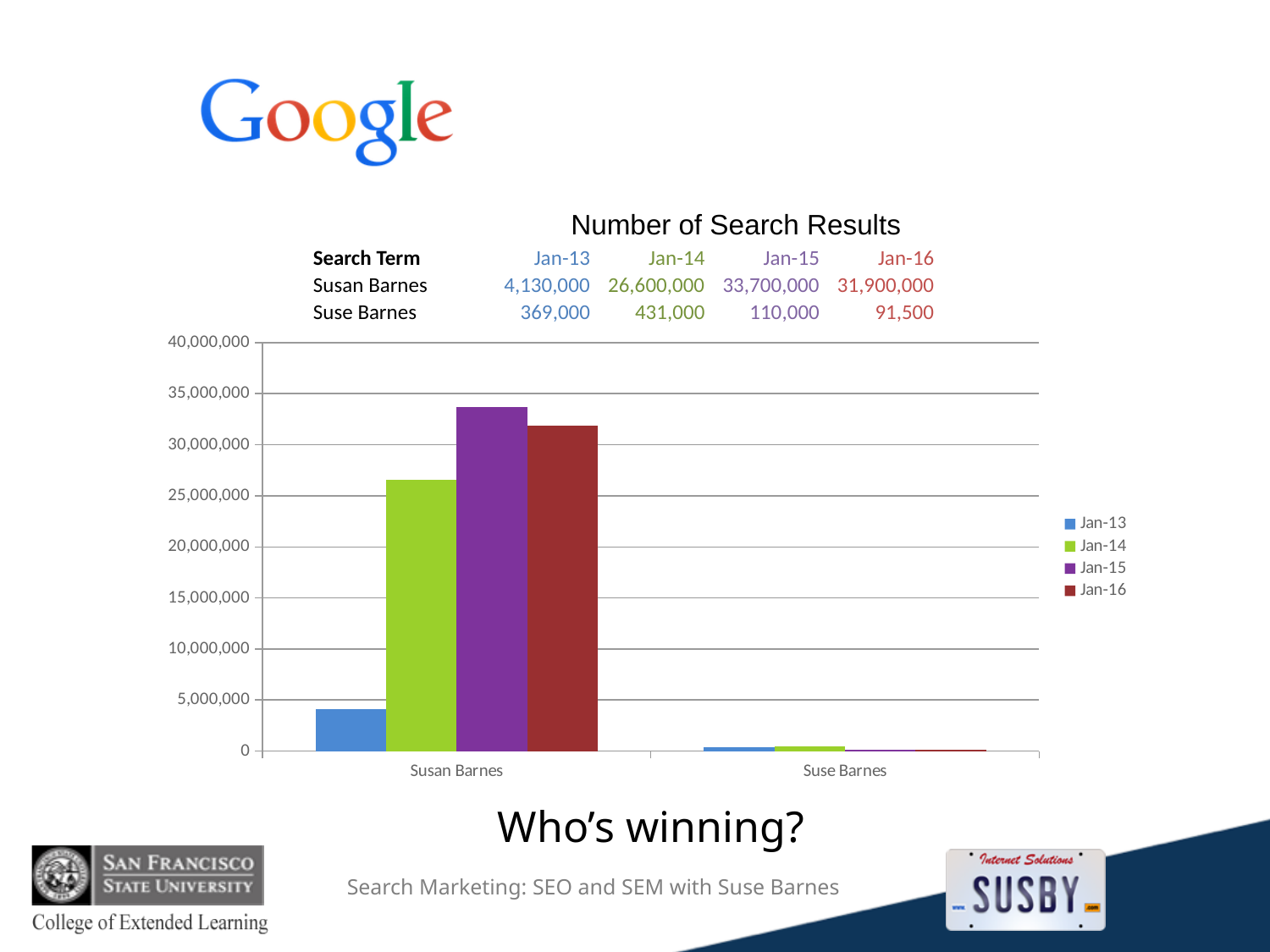
How many categories are shown on the x axis? 2 Do Suse Barnes's search results rise or fall from Jan-14 to Jan-16? fall How many series does the legend list? 4 What type of chart is shown on the slide? bar chart What is the number of search results for Susan Barnes in Jan-14? 26,600,000 What is the difference between Susan Barnes's Jan-15 and Jan-16 search results? 1,800,000 What is the number of search results for Suse Barnes in Jan-16? 91,500 In which period did Suse Barnes have the lowest number of search results? Jan-16 What is the title of the table above the chart? Number of Search Results Which is larger for Suse Barnes: Jan-13 or Jan-14 search results? Jan-14 In which period did Susan Barnes have the highest number of search results? Jan-15 Is the value for Susan Barnes in Jan-13 greater or less than 5,000,000? less